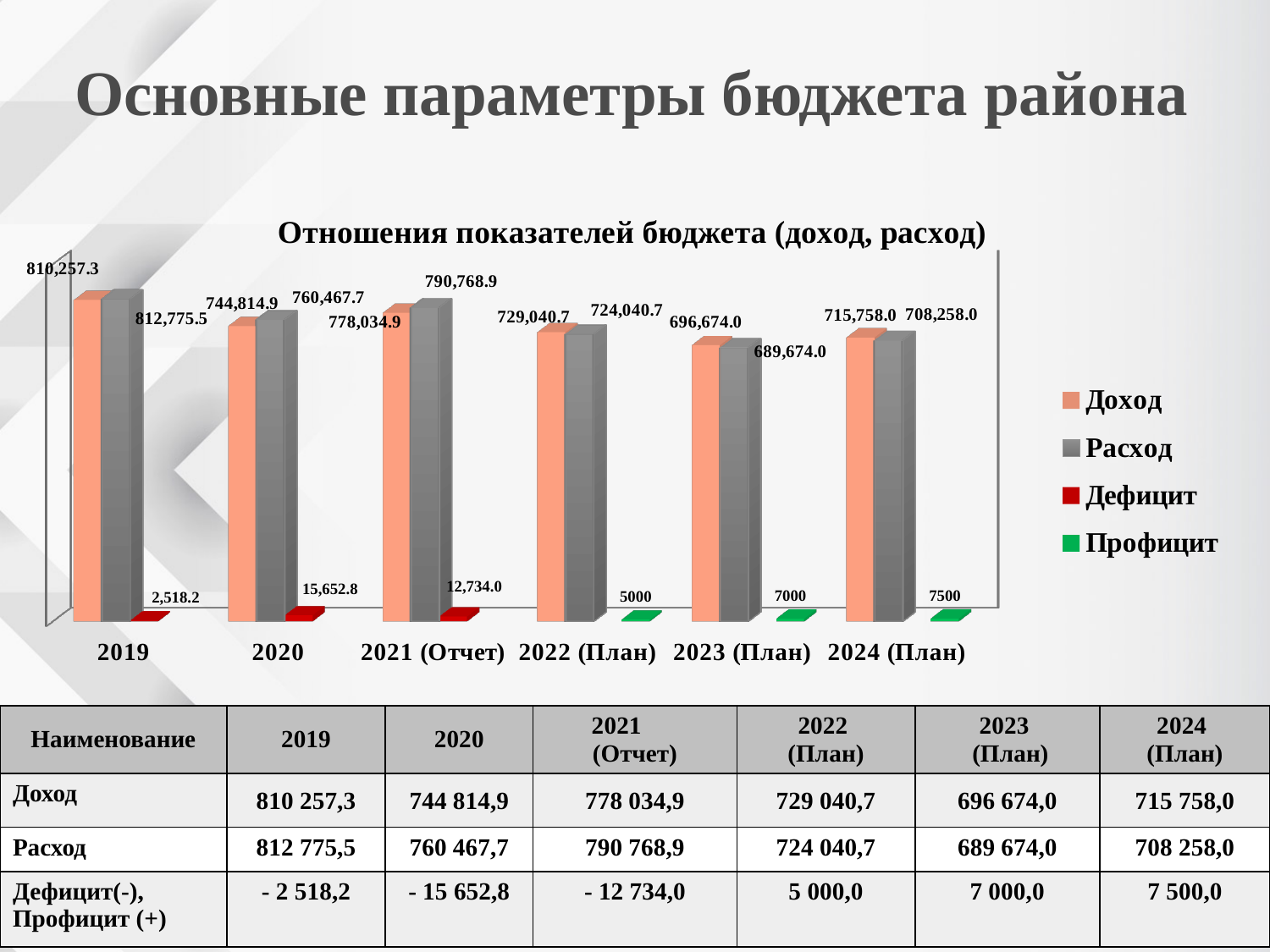
What is the value of Дефицит for 2020? 15,652.8 What kind of chart is shown on the slide? bar chart What is the title of the chart? Отношения показателей бюджета (доход, расход) Which category has the lowest Расход value? 2023 (План) What is the value of Расход for 2021 (Отчет)? 790,768.9 How many series does the legend list? 4 What is the value of Доход for 2019? 810,257.3 What is the difference between Расход and Доход for 2022 (План)? 5,000.0 Which category has the highest Доход value? 2019 Which is larger for 2020: Доход or Расход? Расход What is the value of Профицит for 2024 (План)? 7500 How many categories are shown on the x axis? 6